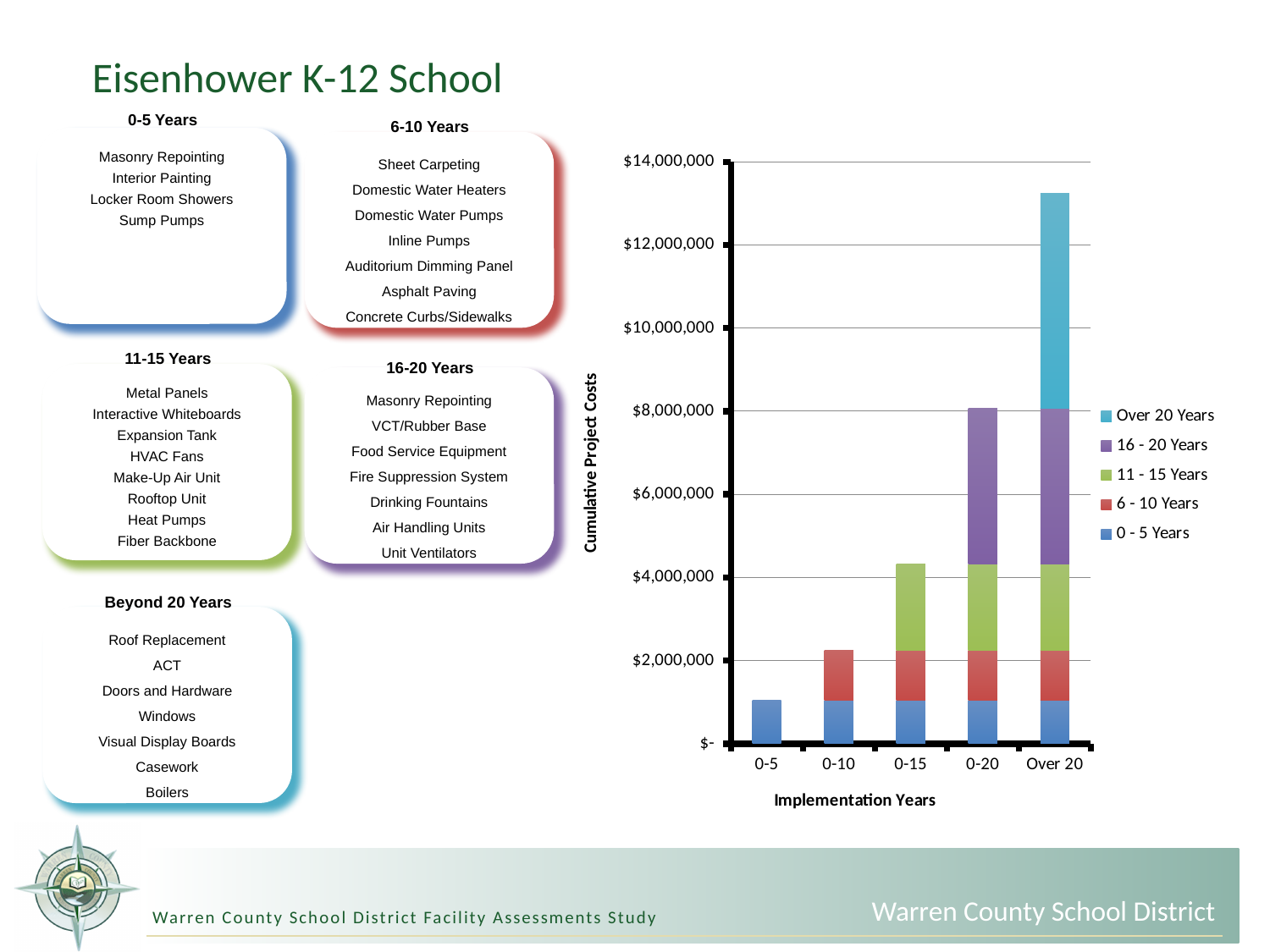
What is the title of the chart's y axis? Cumulative Project Costs Do the cumulative project costs rise or fall moving from 0-5 to Over 20 along the x axis? Rise What is the title of the chart's x axis? Implementation Years Which implementation-year category has the highest cumulative project cost? Over 20 Which has the larger total cumulative project cost, 0-15 or 0-20? 0-20 What kind of chart is shown on the slide? Stacked bar chart Is the total cumulative project cost for 0-5 greater or less than $2,000,000? less How many implementation-year categories are shown on the x axis of the chart? 5 Is the total cumulative project cost for 0-20 greater or less than $6,000,000? greater Which implementation-year category has the lowest cumulative project cost? 0-5 How many series does the chart's legend list? 5 Is the total cumulative project cost for Over 20 greater or less than $12,000,000? greater